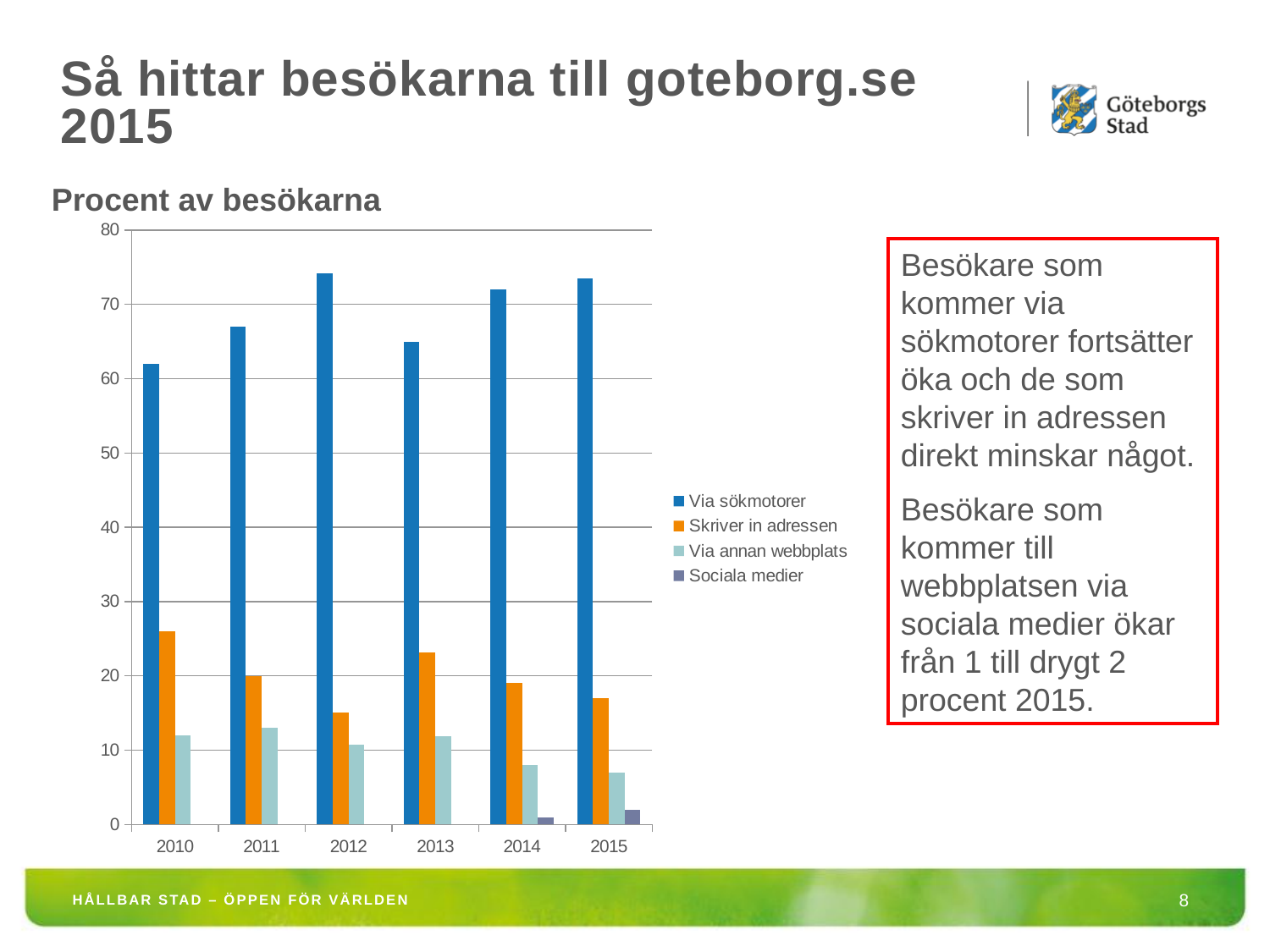
How many years are shown on the x axis? 6 What is the title shown above the chart? Procent av besökarna Which year has the highest value for Skriver in adressen? 2010 Is the value for Via sökmotorer in 2013 greater or less than 70? less Is the value for Via annan webbplats in 2014 greater or less than 10? less What kind of chart is shown on the slide? bar chart How many series does the legend list? 4 Which is larger, Via sökmotorer in 2010 or Via sökmotorer in 2011? 2011 Does the value for Sociala medier rise or fall from 2014 to 2015? rise Is the value for Via sökmotorer in 2010 greater or less than 60? greater Which is larger, Skriver in adressen in 2013 or Skriver in adressen in 2014? 2013